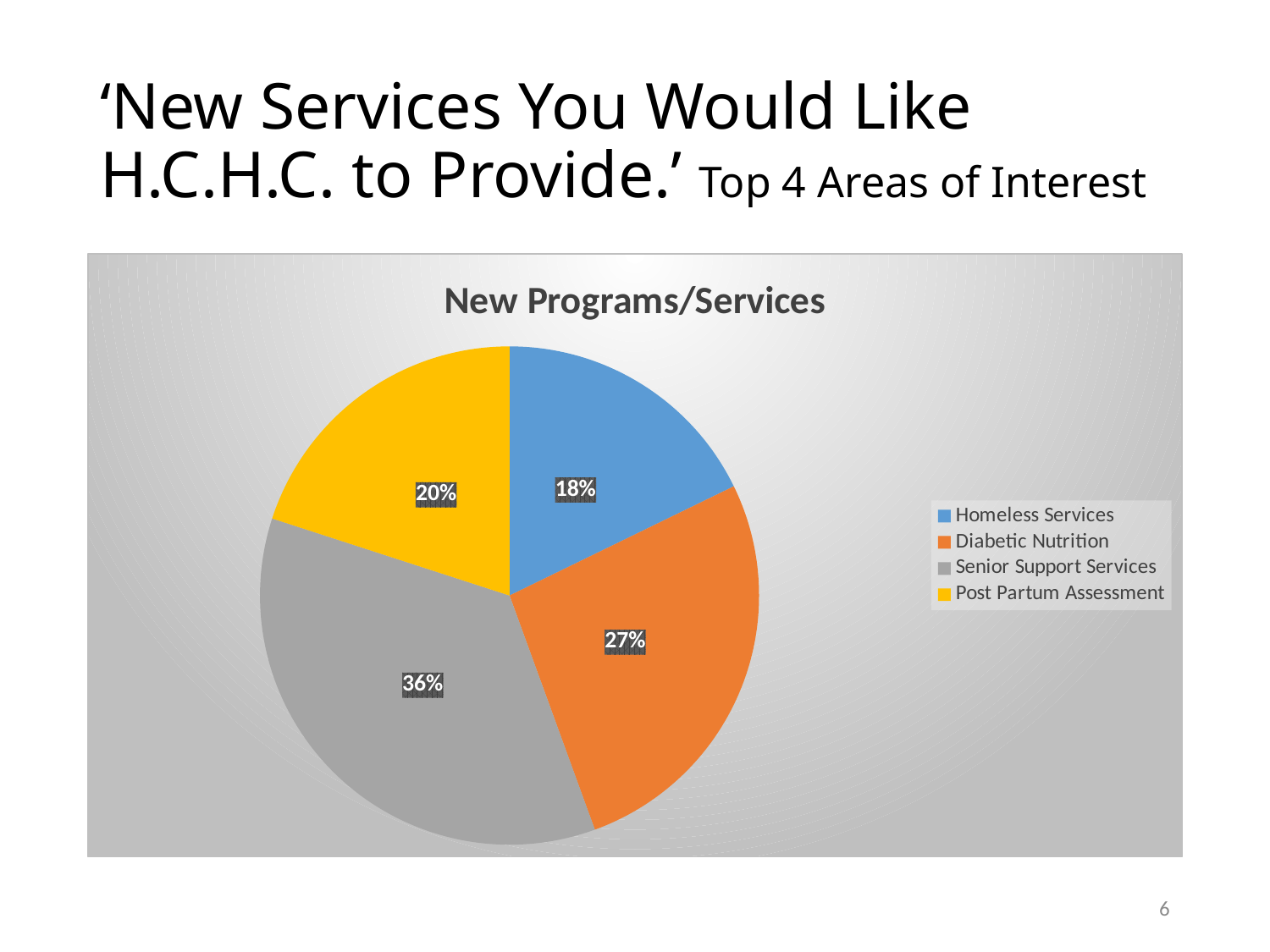
Which colour represents Diabetic Nutrition in the chart? orange Which category has the smallest share of the pie? Homeless Services What percentage of the pie is Post Partum Assessment? 20% What is the difference in percentage points between Senior Support Services and Diabetic Nutrition? 9 What percentage of the pie is Diabetic Nutrition? 27% Which category has the largest share of the pie? Senior Support Services Which is larger, the share for Post Partum Assessment or the share for Homeless Services? Post Partum Assessment What percentage of the pie is Homeless Services? 18% What is the title of the chart? New Programs/Services What percentage of the pie is Senior Support Services? 36% What type of chart is shown on the slide? pie chart How many categories does the pie chart show? 4